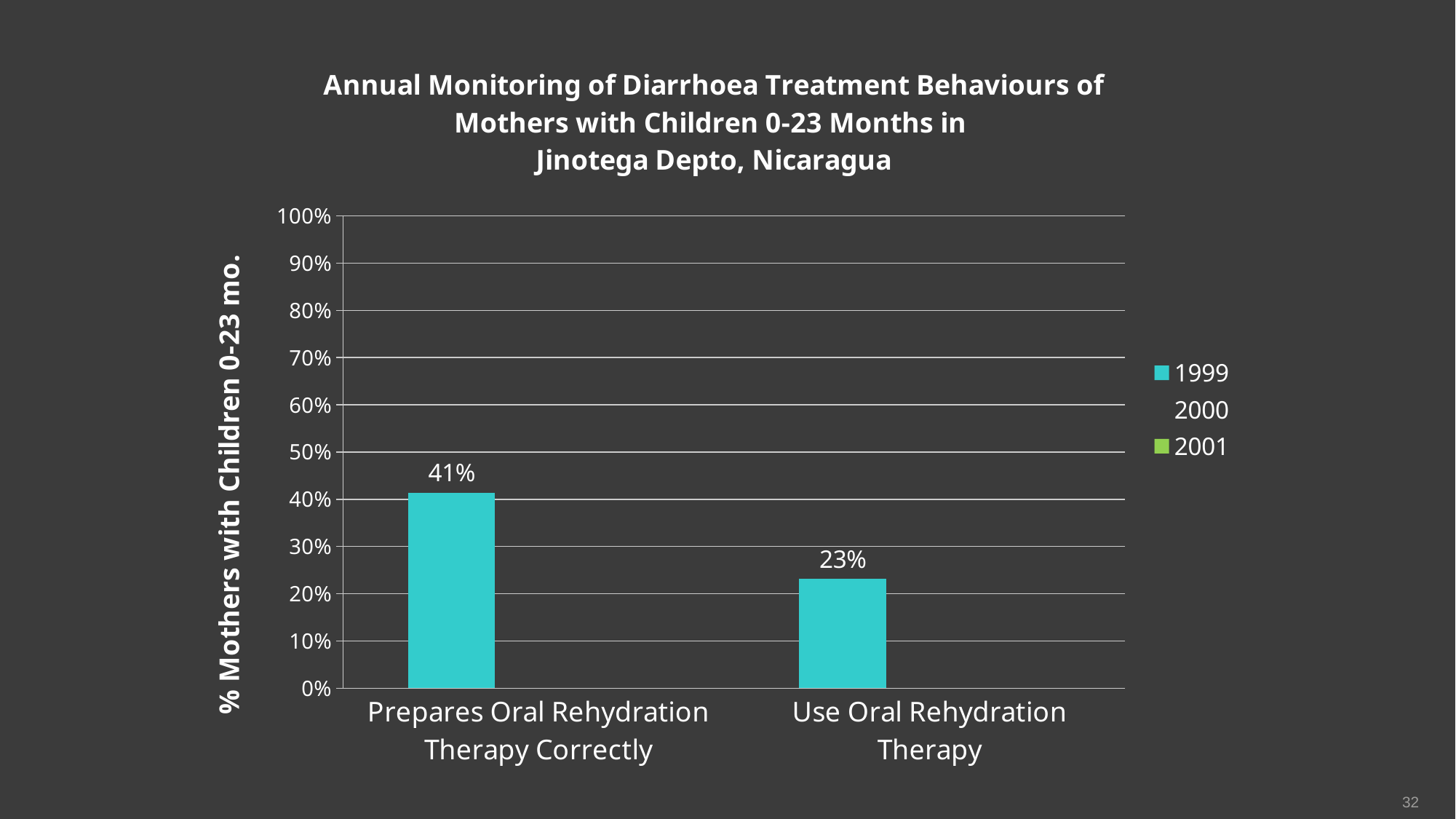
How many categories are shown on the x axis? 2 What is the label of the y axis? % Mothers with Children 0-23 mo. Is the 1999 value for Prepares Oral Rehydration Therapy Correctly greater or less than 50%? less Which category has the higher 1999 value? Prepares Oral Rehydration Therapy Correctly What kind of chart is shown on the slide? bar chart What is the difference between the 1999 values for Prepares Oral Rehydration Therapy Correctly and Use Oral Rehydration Therapy? 18% How many series does the legend list? 3 Is the 1999 value for Prepares Oral Rehydration Therapy Correctly larger or smaller than the 1999 value for Use Oral Rehydration Therapy? larger Is the 1999 value for Use Oral Rehydration Therapy greater or less than 30%? less What is the 1999 value for Use Oral Rehydration Therapy? 23% What is the 1999 value for Prepares Oral Rehydration Therapy Correctly? 41% Which category has the lower 1999 value? Use Oral Rehydration Therapy